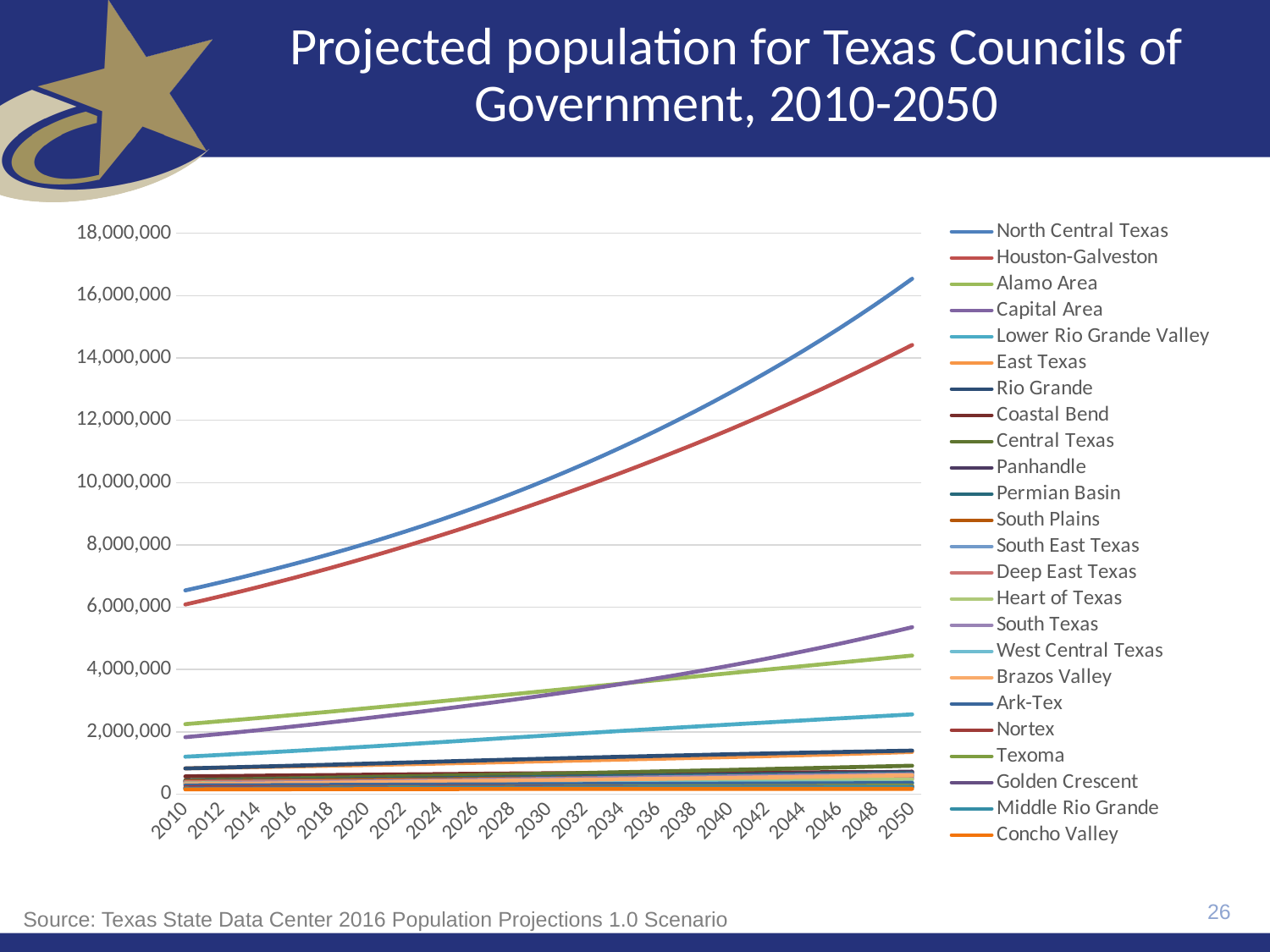
Is the projected population for Houston-Galveston in 2050 greater or less than 14,000,000? greater What is the title of the chart? Projected population for Texas Councils of Government, 2010-2050 Is the projected population for Capital Area in 2050 greater or less than 6,000,000? less Is the projected population for North Central Texas in 2050 greater or less than 16,000,000? greater What kind of chart is shown on the slide? line chart How many series does the legend list? 24 Does the projected population for North Central Texas rise or fall from 2010 to 2050? rise In 2050, which has the larger projected population, Capital Area or Alamo Area? Capital Area Which council of government has the highest projected population in 2050? North Central Texas